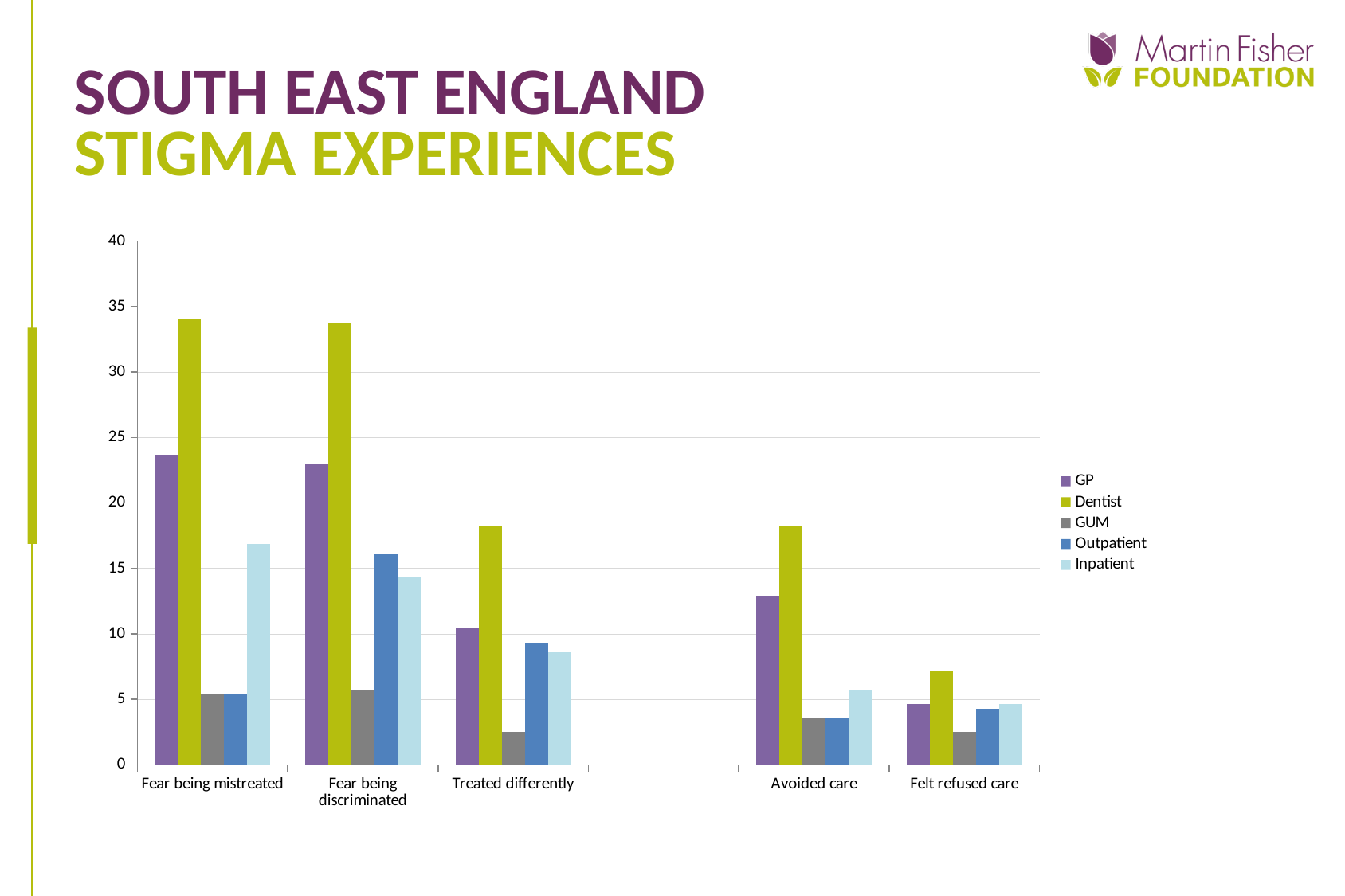
How many category labels appear on the x axis? 5 How many series does the legend list? 5 Which series has the lowest value for Treated differently? GUM Is the Dentist value for Fear being mistreated greater or less than 30? greater What kind of chart is shown on the slide? Bar chart Which series has the highest value for Felt refused care? Dentist Is the GP value for Fear being mistreated greater or less than 20? greater For Fear being discriminated, which is larger: the Outpatient value or the Inpatient value? Outpatient Is the Dentist value for Avoided care greater or less than 20? less For Fear being mistreated, which is larger: the GP value or the Inpatient value? GP Which series has the highest value for Fear being mistreated? Dentist